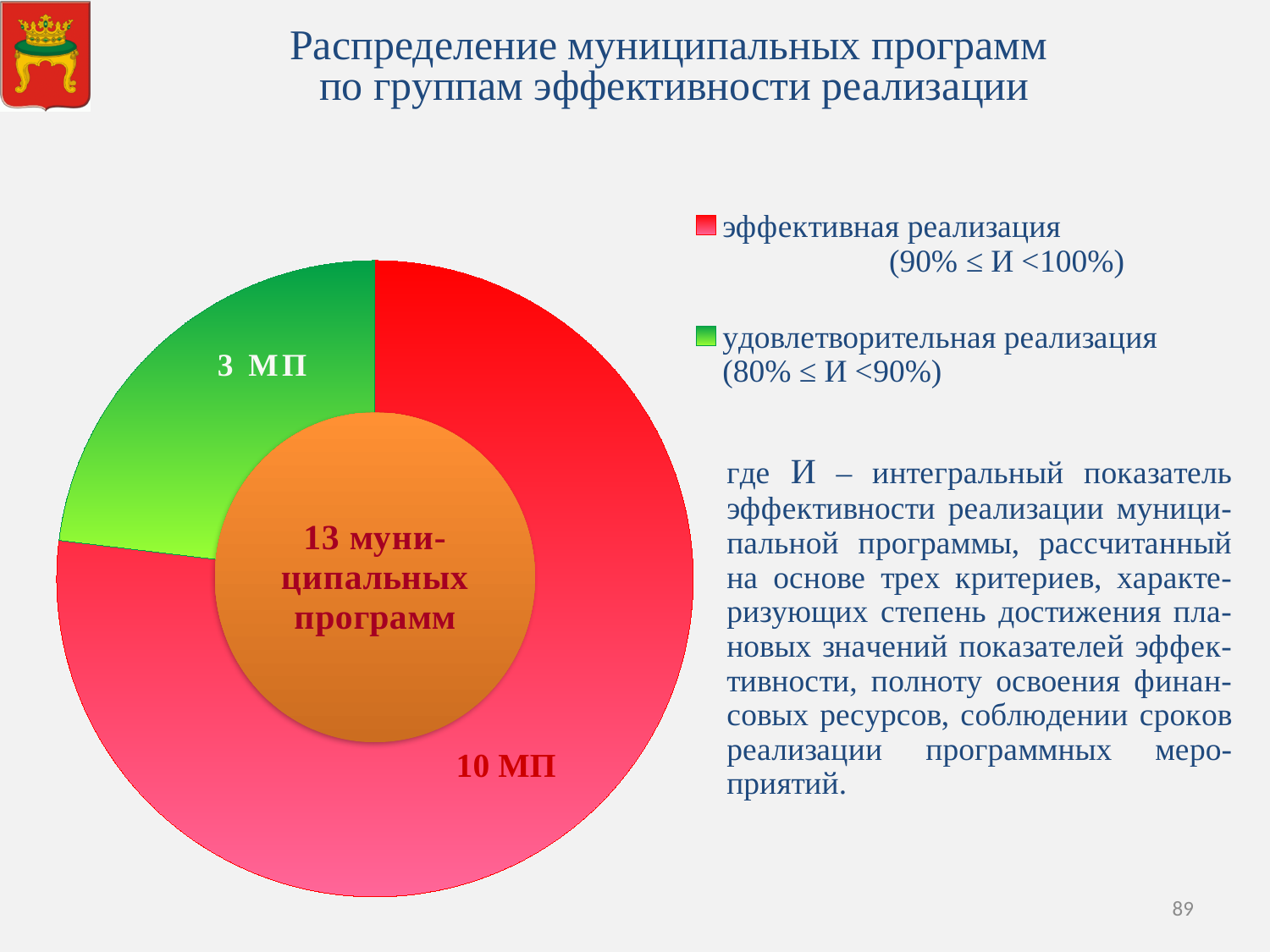
How many municipal programs fall into the "эффективная реализация" group? 10 МП What colour represents the "удовлетворительная реализация" group? Green What type of chart is shown on the slide? Doughnut (ring) chart Which group has the largest number of municipal programs? эффективная реализация Which group has the smallest number of municipal programs? удовлетворительная реализация How many entries does the legend list? 2 How many municipal programs fall into the "удовлетворительная реализация" group? 3 МП Which group has more programs: "эффективная реализация" or "удовлетворительная реализация"? эффективная реализация How many slices does the pie chart have? 2 What is the total number of municipal programs shown in the centre of the chart? 13 How many more programs are in the "эффективная реализация" group than in the "удовлетворительная реализация" group? 7 What range of the indicator И corresponds to the "эффективная реализация" group according to the legend? 90% ≤ И <100%